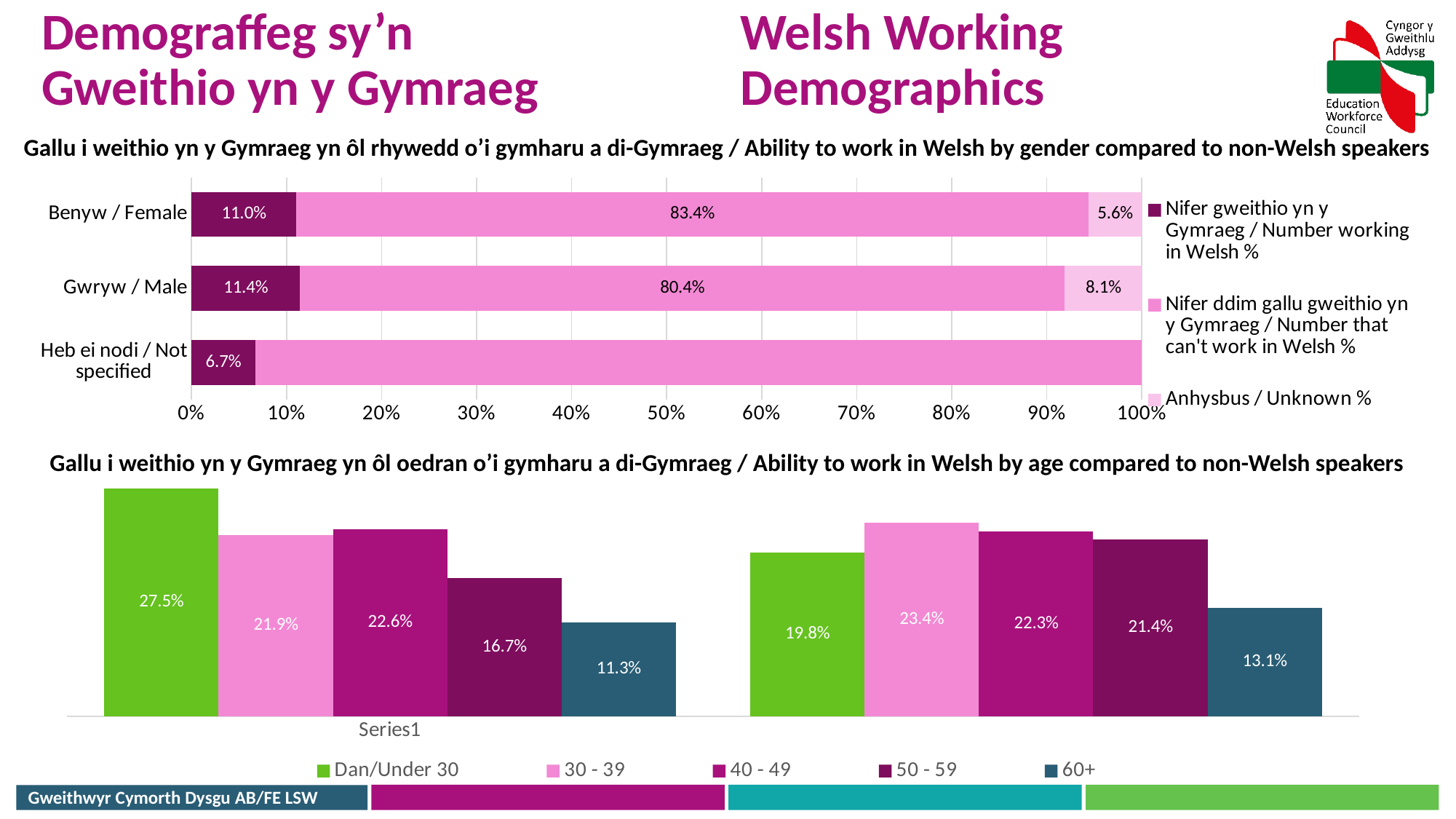
In the bottom chart (Ability to work in Welsh by age), what is the value for Dan/Under 30 in the left group of bars? 27.5% In the top chart (Ability to work in Welsh by gender), what is the 'Number that can't work in Welsh %' value for Gwryw / Male? 80.4% In the top chart (Ability to work in Welsh by gender), what is the 'Number working in Welsh %' value for Benyw / Female? 11.0% In the top chart (Ability to work in Welsh by gender), which has the larger 'Number that can't work in Welsh %' value, Benyw / Female or Gwryw / Male? Benyw / Female In the bottom chart (Ability to work in Welsh by age), which age group has the lowest value in the right group of bars? 60+ In the top chart (Ability to work in Welsh by gender), what is the 'Number working in Welsh %' value for Heb ei nodi / Not specified? 6.7% In the top chart (Ability to work in Welsh by gender), what is the difference between the 'Number working in Welsh %' values for Gwryw / Male and Benyw / Female? 0.4% In the top chart (Ability to work in Welsh by gender), how many series does the legend list? 3 What kind of chart is the top chart (Ability to work in Welsh by gender)? Stacked bar chart In the bottom chart (Ability to work in Welsh by age), what is the difference between the 60+ values in the right group (13.1%) and the left group (11.3%)? 1.8% In the top chart (Ability to work in Welsh by gender), what is the 'Anhysbus / Unknown %' value for Gwryw / Male? 8.1% In the bottom chart (Ability to work in Welsh by age), what is the value for 30 - 39 in the right group of bars? 23.4%